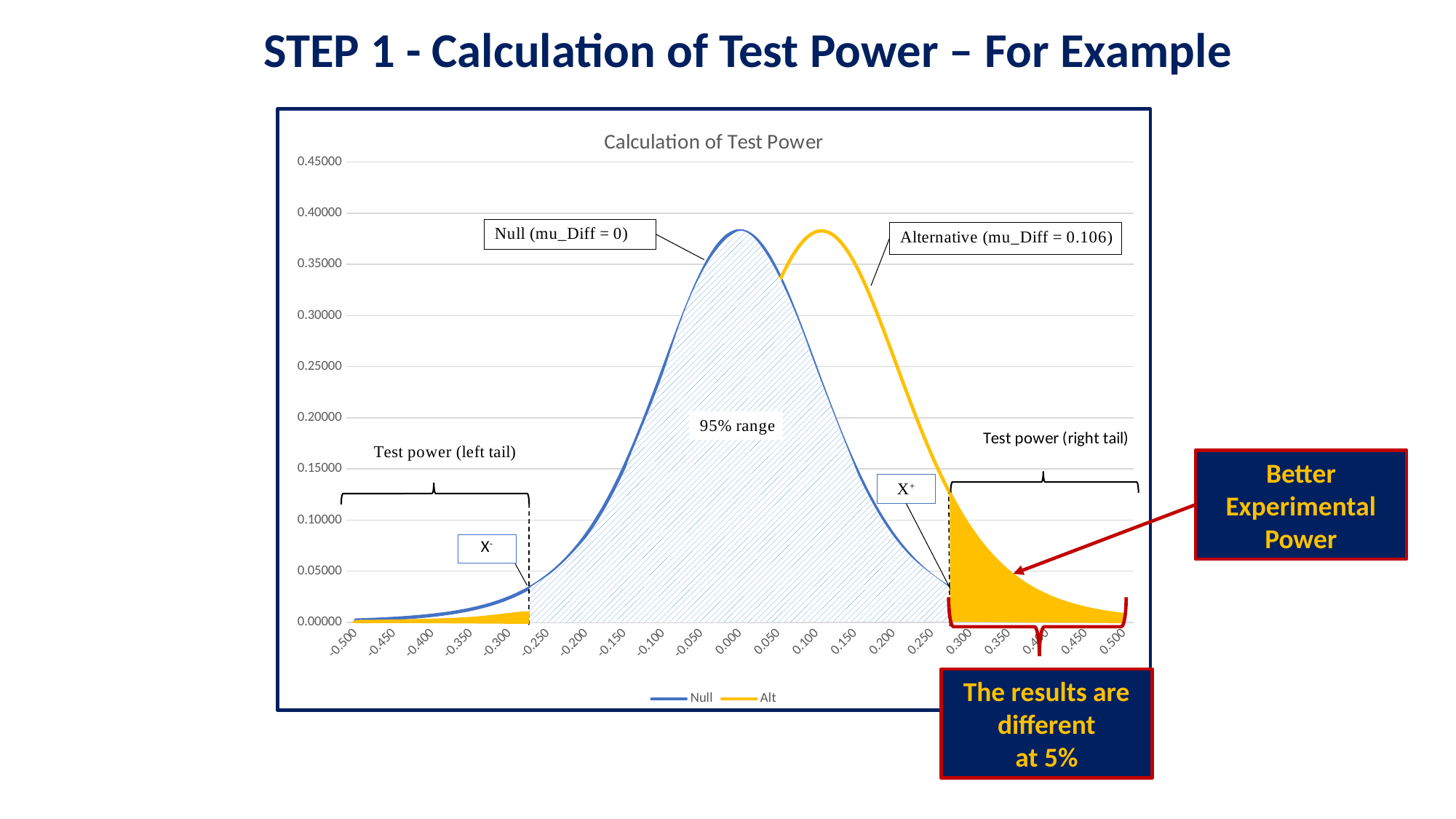
Is the value of the Null curve at x = 0.300 greater or less than 0.05000? less What is the highest value labelled on the y axis? 0.45000 What is the title of the chart? Calculation of Test Power Which series has its peak further to the right on the x axis, Null or Alt? Alt Is the peak value of the Null curve greater or less than 0.35000? greater How many series does the legend list? 2 What kind of chart is shown on the slide? Line chart What mu_Diff value is given for the Alternative curve in the annotation? 0.106 Which colour is used for the Alt series? Yellow What mu_Diff value is given for the Null curve in the annotation? 0 Is the peak value of the Alt curve greater or less than 0.40000? less How many tick labels are shown on the x axis? 21